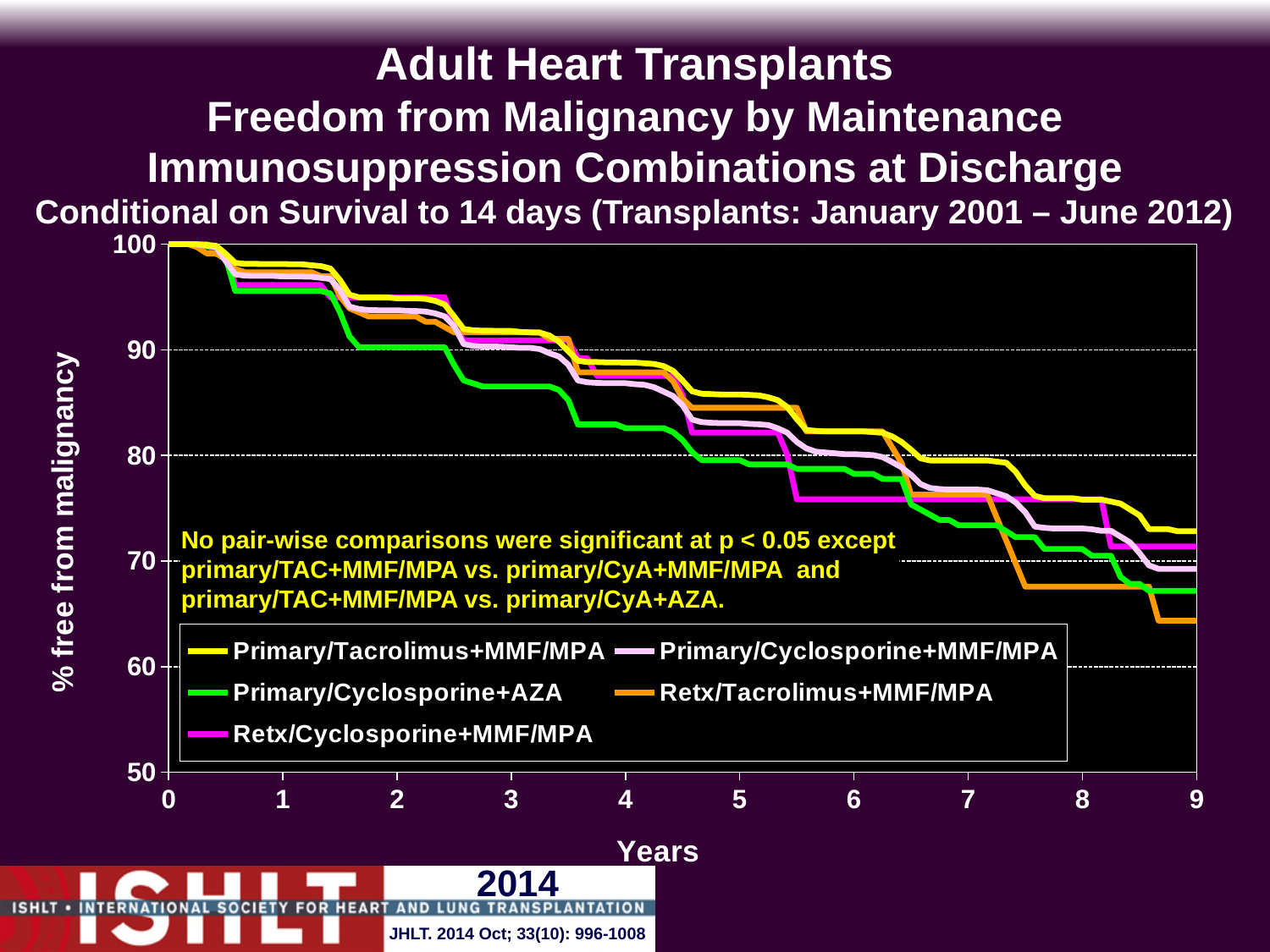
How many series does the legend list? 5 Is the value for Primary/Tacrolimus+MMF/MPA at 5 years greater or less than 80? greater What kind of chart is shown on the slide? line chart Is the value for Primary/Cyclosporine+AZA at 3 years greater or less than 90? less At 9 years, which series has the lowest freedom from malignancy? Retx/Tacrolimus+MMF/MPA At 3 years, which is higher: Primary/Tacrolimus+MMF/MPA or Primary/Cyclosporine+AZA? Primary/Tacrolimus+MMF/MPA At 9 years, which series has the highest freedom from malignancy? Primary/Tacrolimus+MMF/MPA Is the value for Retx/Cyclosporine+MMF/MPA at 6 years greater or less than 80? less Do the curves rise or fall as years since transplant increase? fall What is the label of the y axis? % free from malignancy